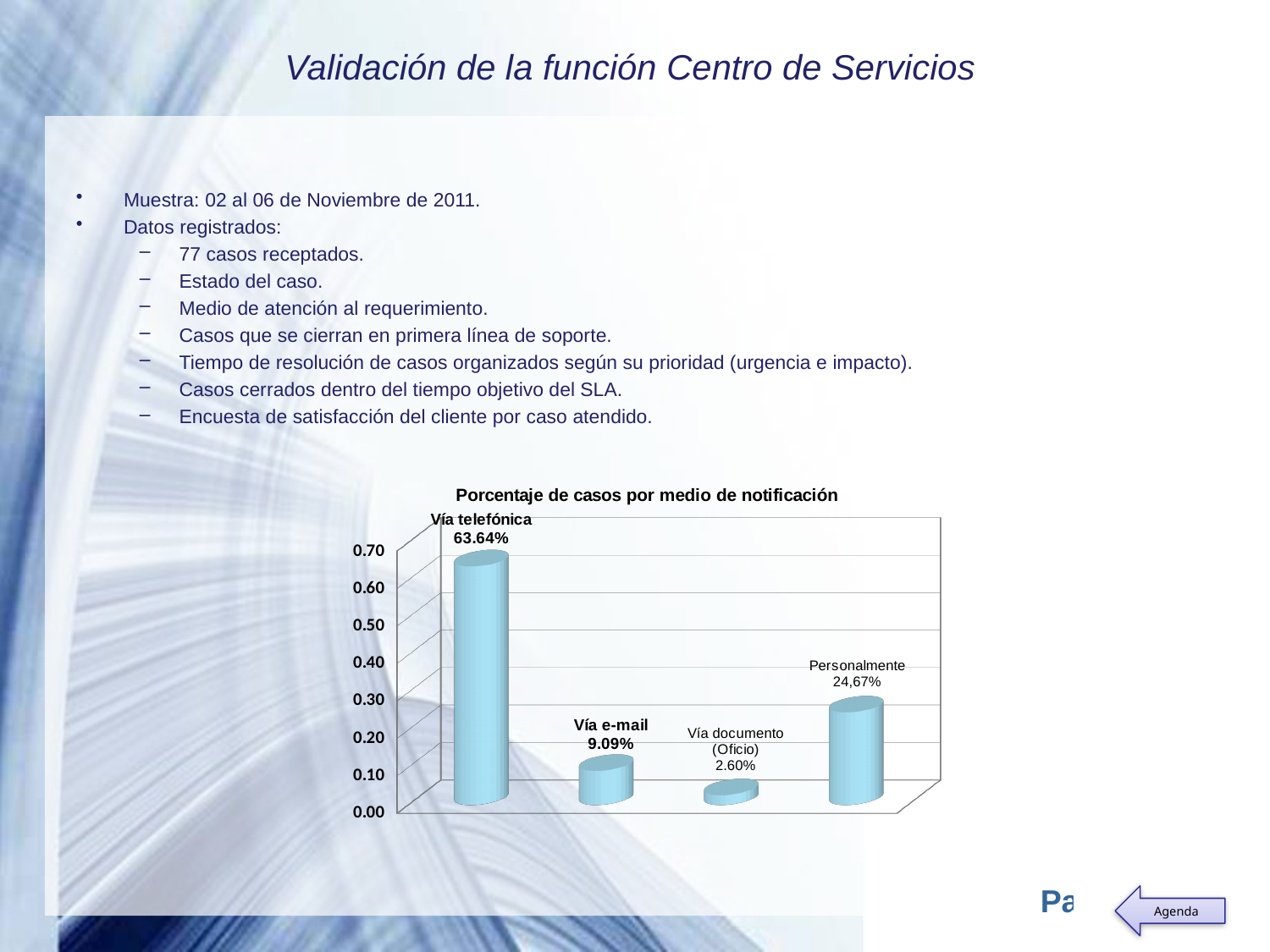
What is the value for Personalmente? 24,67% How many categories are shown in the chart? 4 What is the difference between the values for Vía telefónica and Vía e-mail? 54.55% What is the value for Vía e-mail? 9.09% Which is larger, the value for Personalmente or the value for Vía e-mail? Personalmente What is the value for Vía documento (Oficio)? 2.60% What is the difference between the values for Vía e-mail and Vía documento (Oficio)? 6.49% Which notification medium has the highest percentage of cases? Vía telefónica What is the title of the chart on the slide? Porcentaje de casos por medio de notificación Which notification medium has the lowest percentage of cases? Vía documento (Oficio) What is the value for Vía telefónica in the chart 'Porcentaje de casos por medio de notificación'? 63.64% What kind of chart is shown on the slide? Bar chart